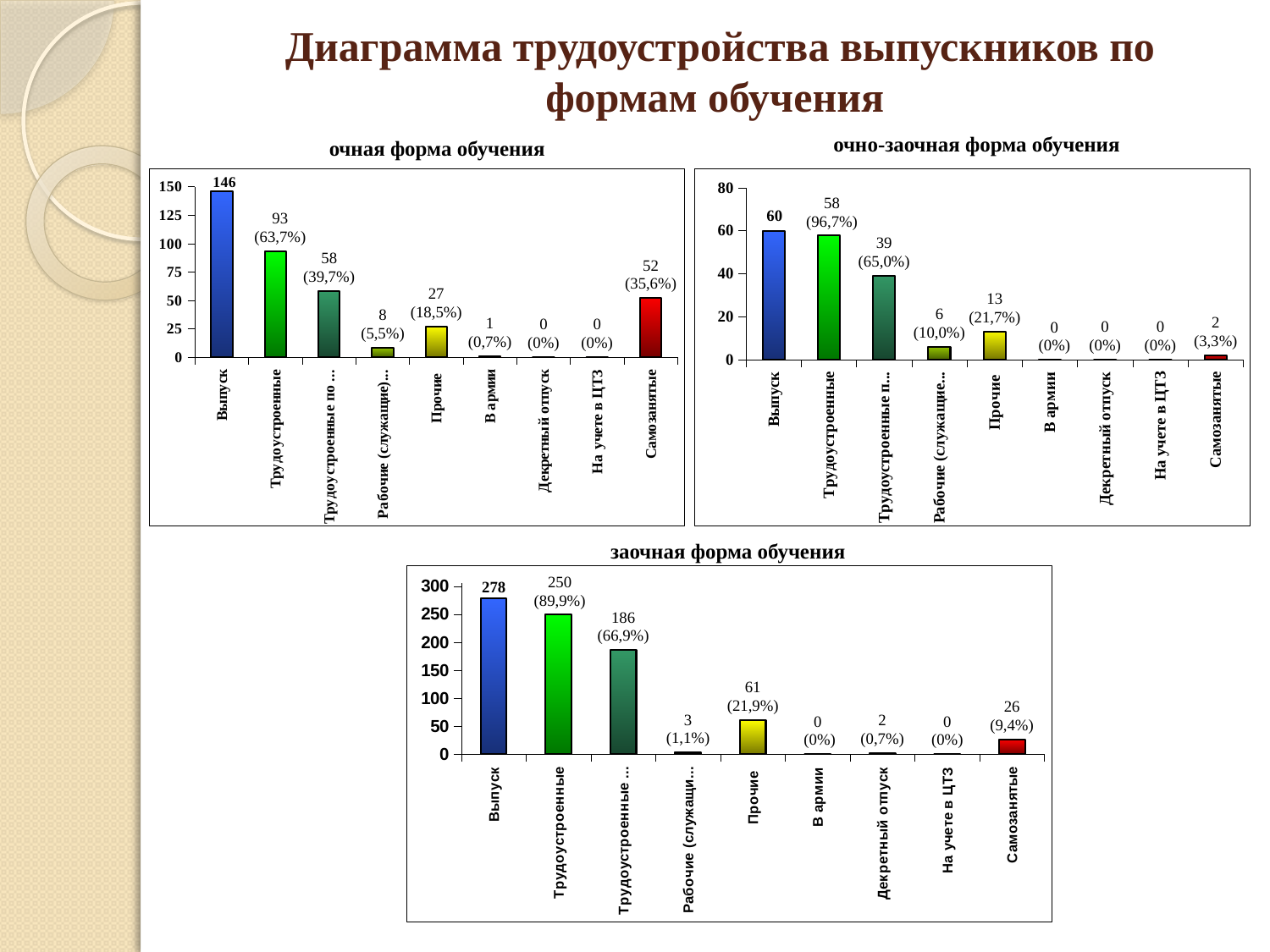
In the chart titled "очно-заочная форма обучения", what is the value for Трудоустроенные? 58 (96,7%) In the chart titled "заочная форма обучения", what is the difference between Трудоустроенные and Самозанятые? 224 How many charts are shown on the slide? 3 How many categories are shown in the chart titled "очно-заочная форма обучения"? 9 In the chart titled "очная форма обучения", is the value for Трудоустроенные greater or less than 75? greater In the chart titled "заочная форма обучения", what is the value for Прочие? 61 (21,9%) In the chart titled "очно-заочная форма обучения", which is larger: Прочие or Самозанятые? Прочие In the chart titled "заочная форма обучения", which category has the highest value? Выпуск In the chart titled "очная форма обучения", what is the value for Самозанятые? 52 (35,6%) In the chart titled "очная форма обучения", what is the difference between Выпуск and Трудоустроенные? 53 In the chart titled "очная форма обучения", what is the value for Выпуск? 146 What type of chart is the chart titled "заочная форма обучения"? bar chart